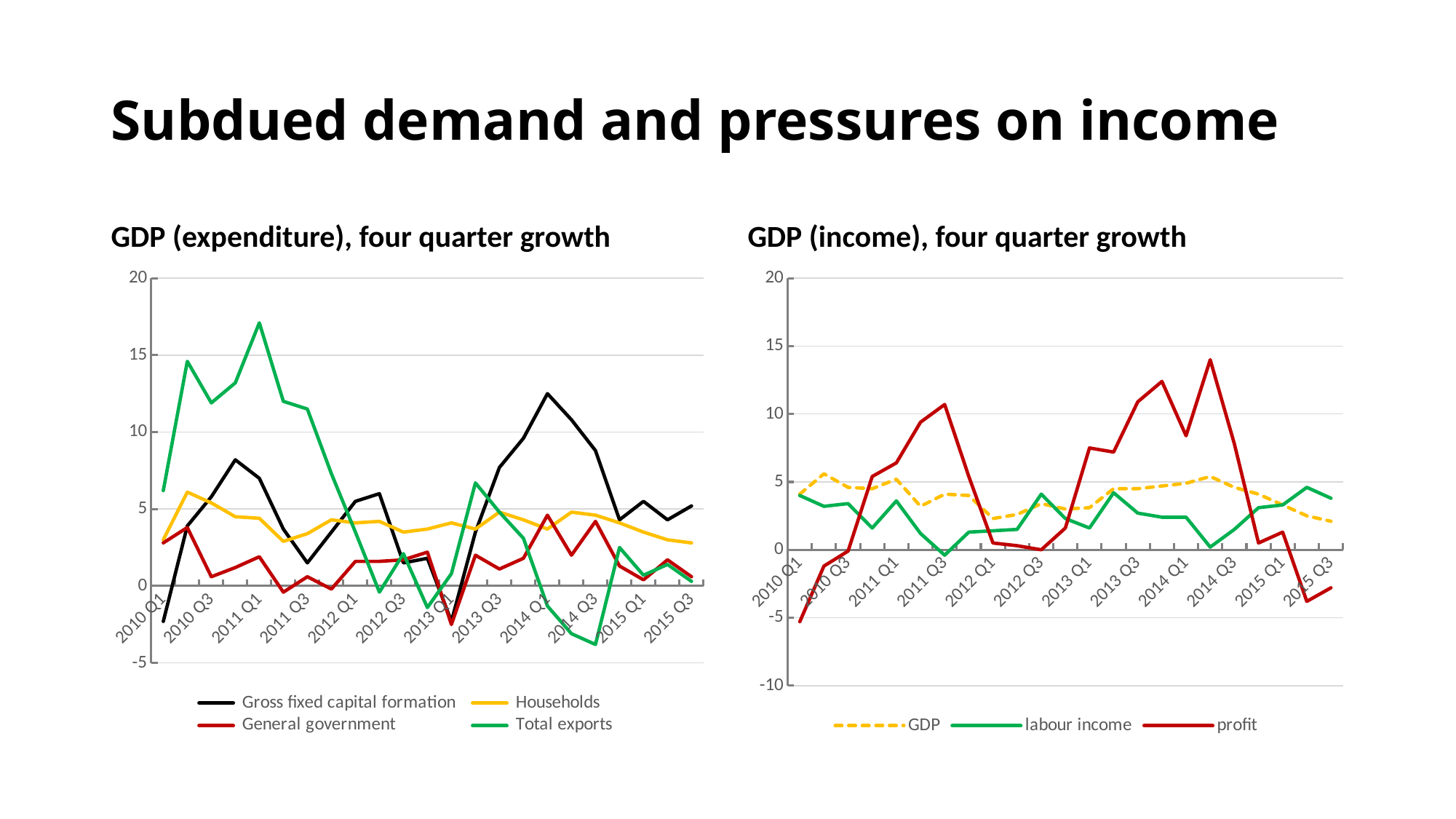
How many series does the legend of the 'GDP (income), four quarter growth' chart list? 3 In the 'GDP (income), four quarter growth' chart, is the value for profit at 2010 Q1 greater or less than 0? less How many series does the legend of the 'GDP (expenditure), four quarter growth' chart list? 4 In the 'GDP (expenditure), four quarter growth' chart, is the value for Total exports at 2011 Q1 greater or less than 15? greater In the 'GDP (expenditure), four quarter growth' chart, what colour is the Total exports line? green In the 'GDP (income), four quarter growth' chart, which series is drawn with a dashed line? GDP In the 'GDP (expenditure), four quarter growth' chart, is the value for Gross fixed capital formation at 2014 Q1 greater or less than 10? greater What kind of chart is the 'GDP (expenditure), four quarter growth' chart? line chart In the 'GDP (expenditure), four quarter growth' chart, which series reaches the highest value on the chart? Total exports In the 'GDP (income), four quarter growth' chart, which series reaches the highest value on the chart? profit